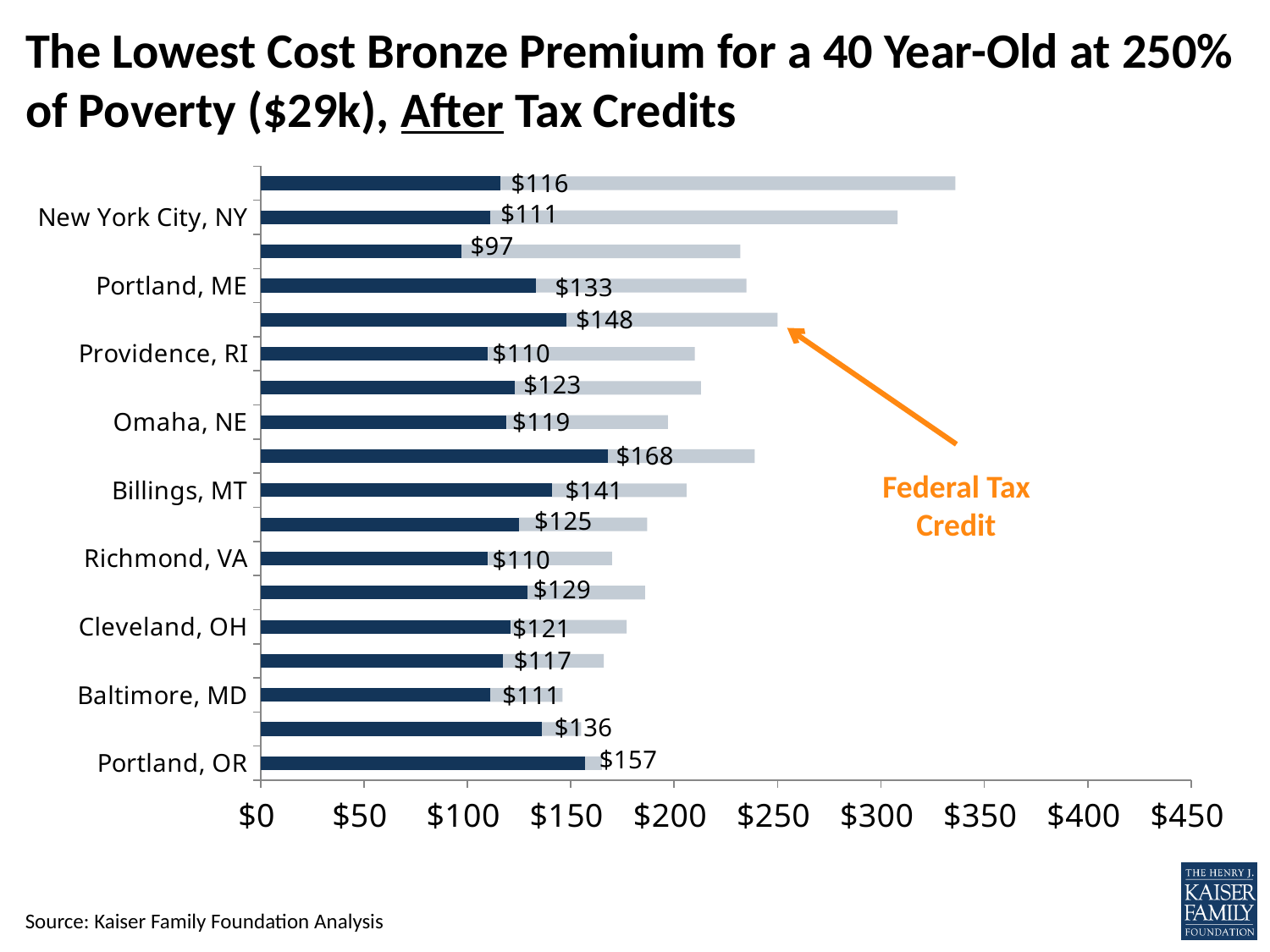
What is the after-tax-credit premium shown for Cleveland, OH? $121 What is the after-tax-credit premium shown for New York City, NY? $111 What is the after-tax-credit premium shown for Portland, ME? $133 What does the orange arrow on the chart point out? Federal Tax Credit Among the cities labeled on the axis, which has the highest after-tax-credit premium? Portland, OR What is the after-tax-credit premium shown for Portland, OR? $157 What kind of chart is shown on the slide? Bar chart Which has a higher after-tax-credit premium, Portland, ME or Omaha, NE? Portland, ME Is the full bar (including the federal tax credit) for New York City, NY greater or less than $300? greater What is the after-tax-credit premium shown for Billings, MT? $141 How many bars are plotted in the chart? 18 What is the difference between the after-tax-credit premiums for Portland, OR and Billings, MT? $16